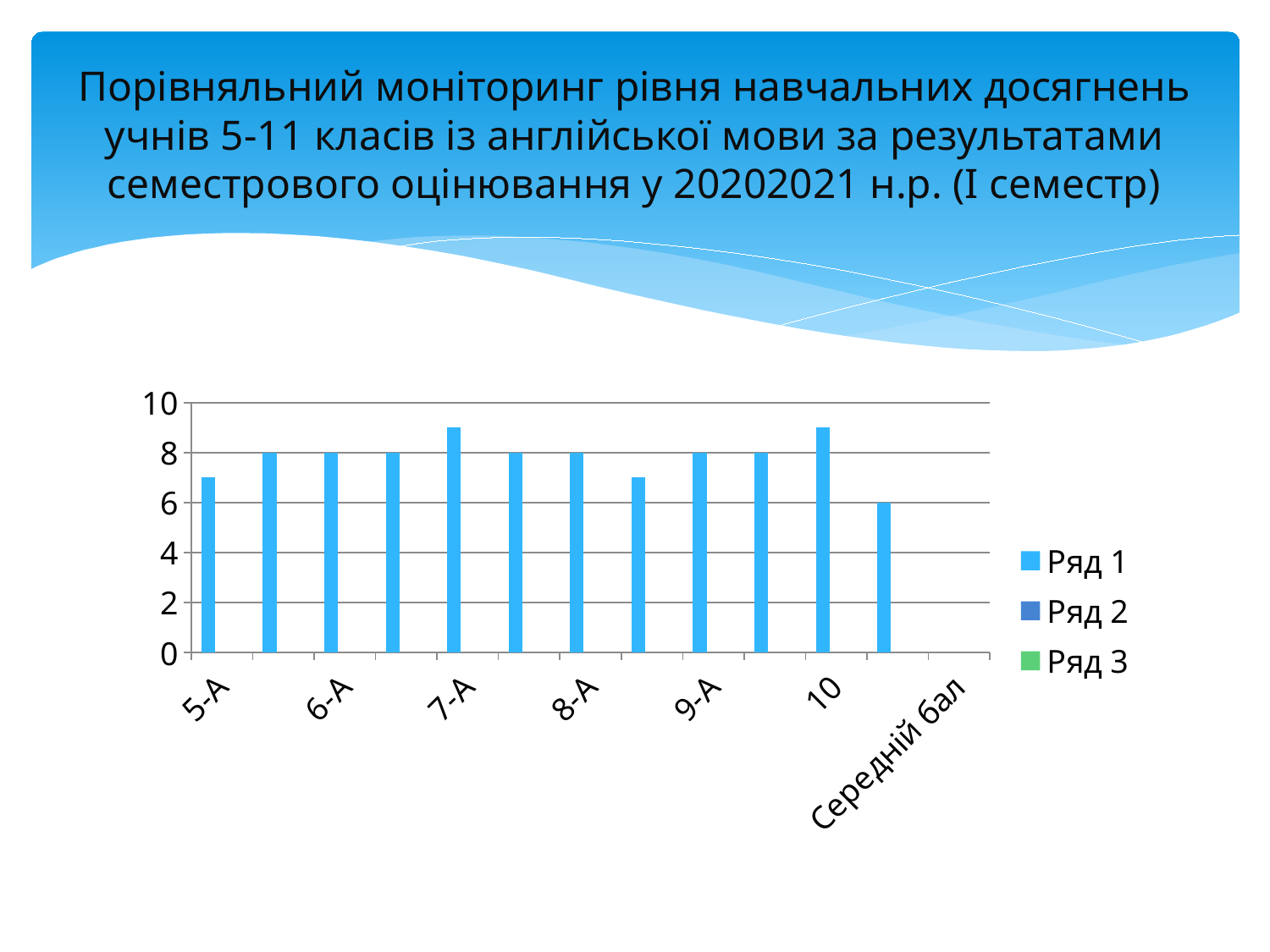
What is the value of the bar for 9-А? 8 Is the value for 5-А greater or less than 8? less What is the value of the bar for 6-А? 8 Which is larger, the value for 7-А or the value for 5-А? 7-А How many bars are plotted in the chart? 12 What type of chart is shown on the slide? bar chart What is the value of the bar for 8-А? 8 Is the value for 7-А greater or less than 8? greater How many series does the legend list? 3 What is the difference between the values for 6-А and 8-А? 0 Is the value for 10 greater or less than 8? greater Which is larger, the value for 10 or the value for 8-А? 10